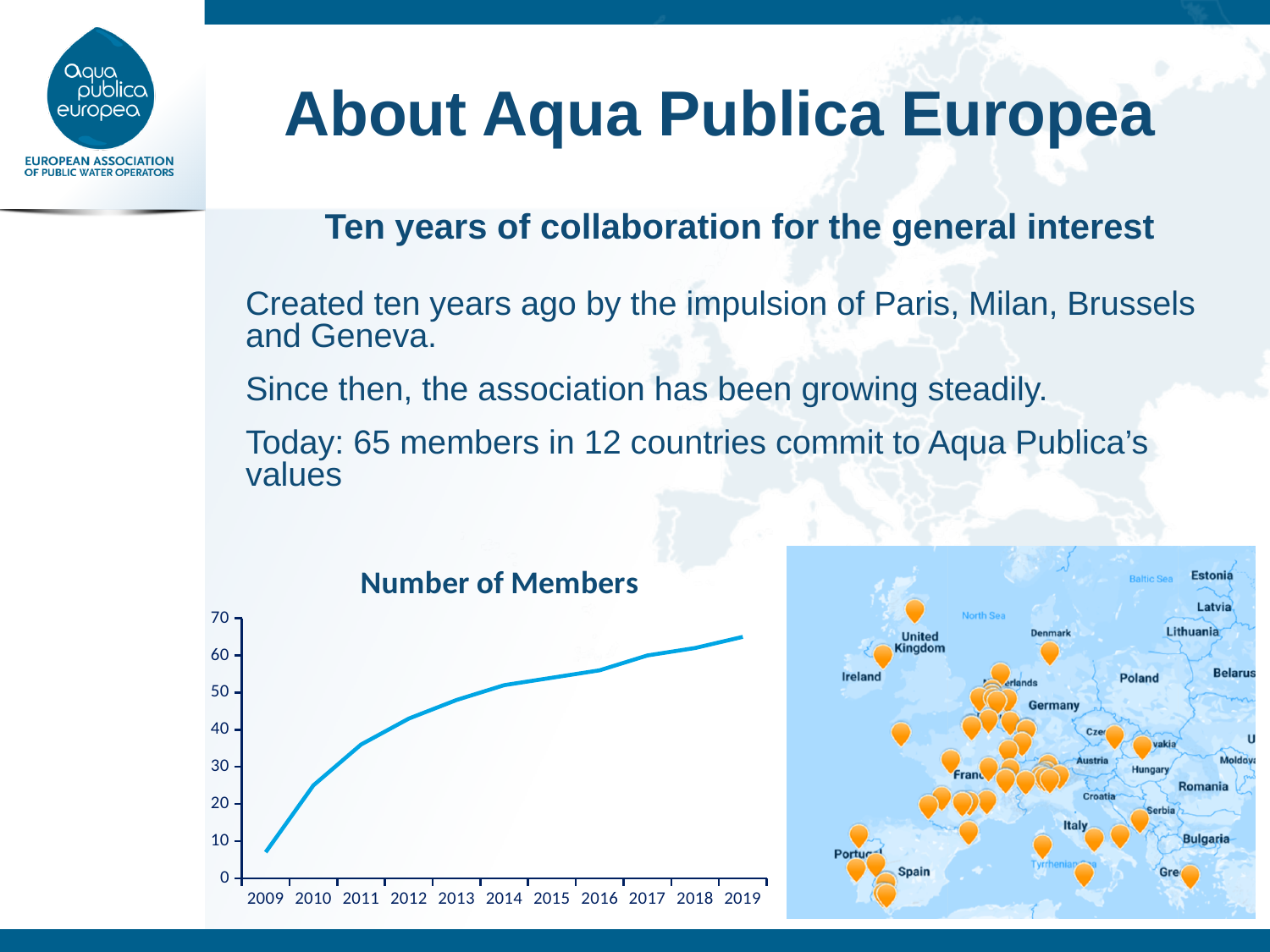
How many years are shown on the x axis of the 'Number of Members' chart? 11 Which year has more members, 2010 or 2014? 2014 Is the number of members in 2019 greater or less than 60? greater Is the number of members in 2011 greater or less than 30? greater Which year has the highest number of members in the chart? 2019 Do the values in the 'Number of Members' chart rise or fall from 2009 to 2019? rise Is the number of members in 2009 greater or less than 10? less Which year has the lowest number of members in the chart? 2009 What is the title of the chart on the slide? Number of Members What kind of chart is the 'Number of Members' chart? line chart What is the first year shown on the x axis of the 'Number of Members' chart? 2009